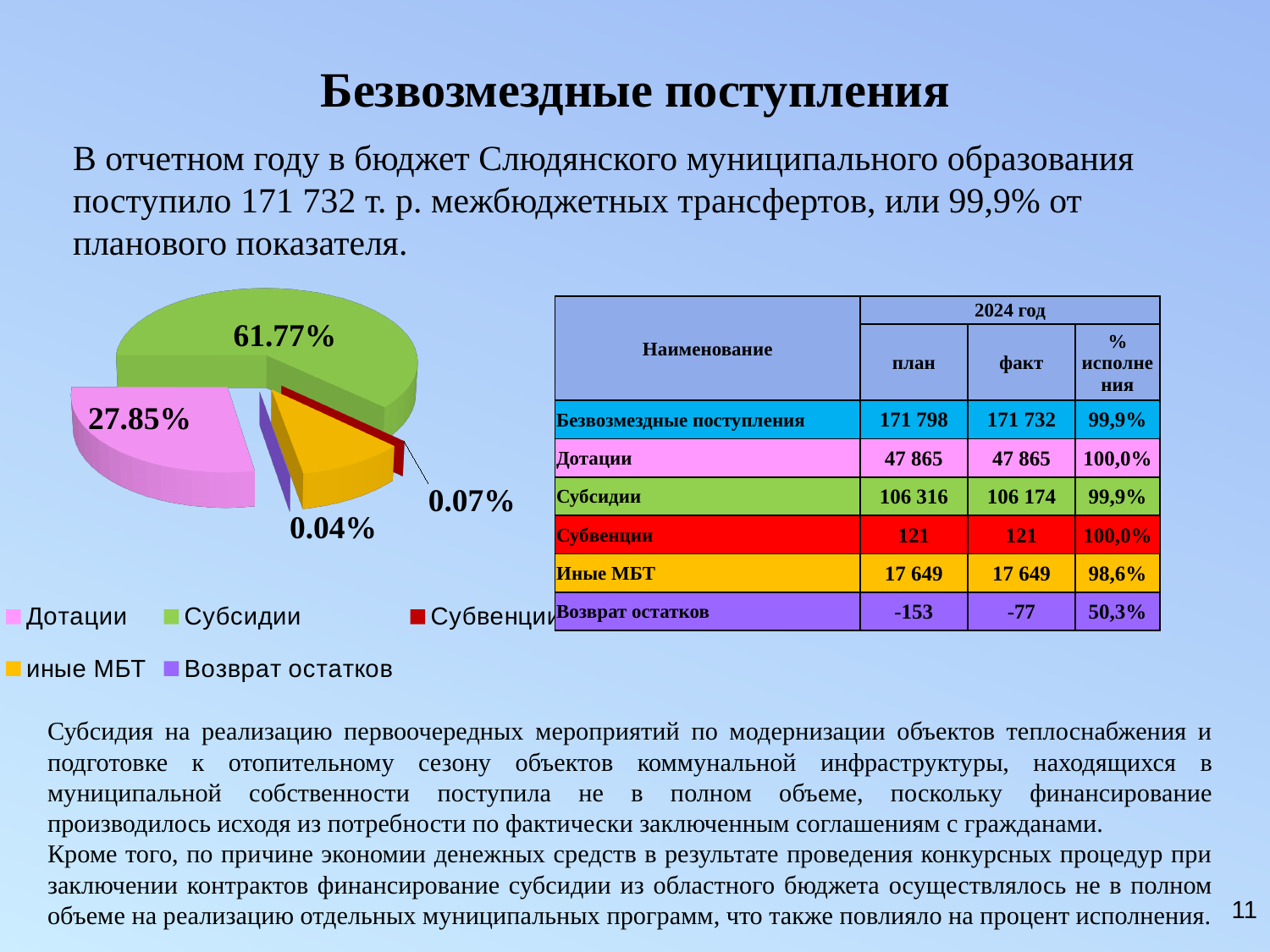
What colour is the Субсидии slice in the pie chart? Green What type of chart is shown on the slide? Pie chart How many categories does the pie chart legend list? 5 What share of the pie chart does Дотации represent? 27.85% Which slice is larger, Дотации or Субсидии? Субсидии What share of the pie chart does Субсидии represent? 61.77% What is the difference in percentage points between the Субсидии slice and the Дотации slice? 33.92% What colour is the Дотации slice in the pie chart? Pink Which category has the smallest slice in the pie chart? Возврат остатков What share of the pie chart does Субвенции represent? 0.07% What share of the pie chart does Возврат остатков represent? 0.04% Which category has the largest slice in the pie chart? Субсидии